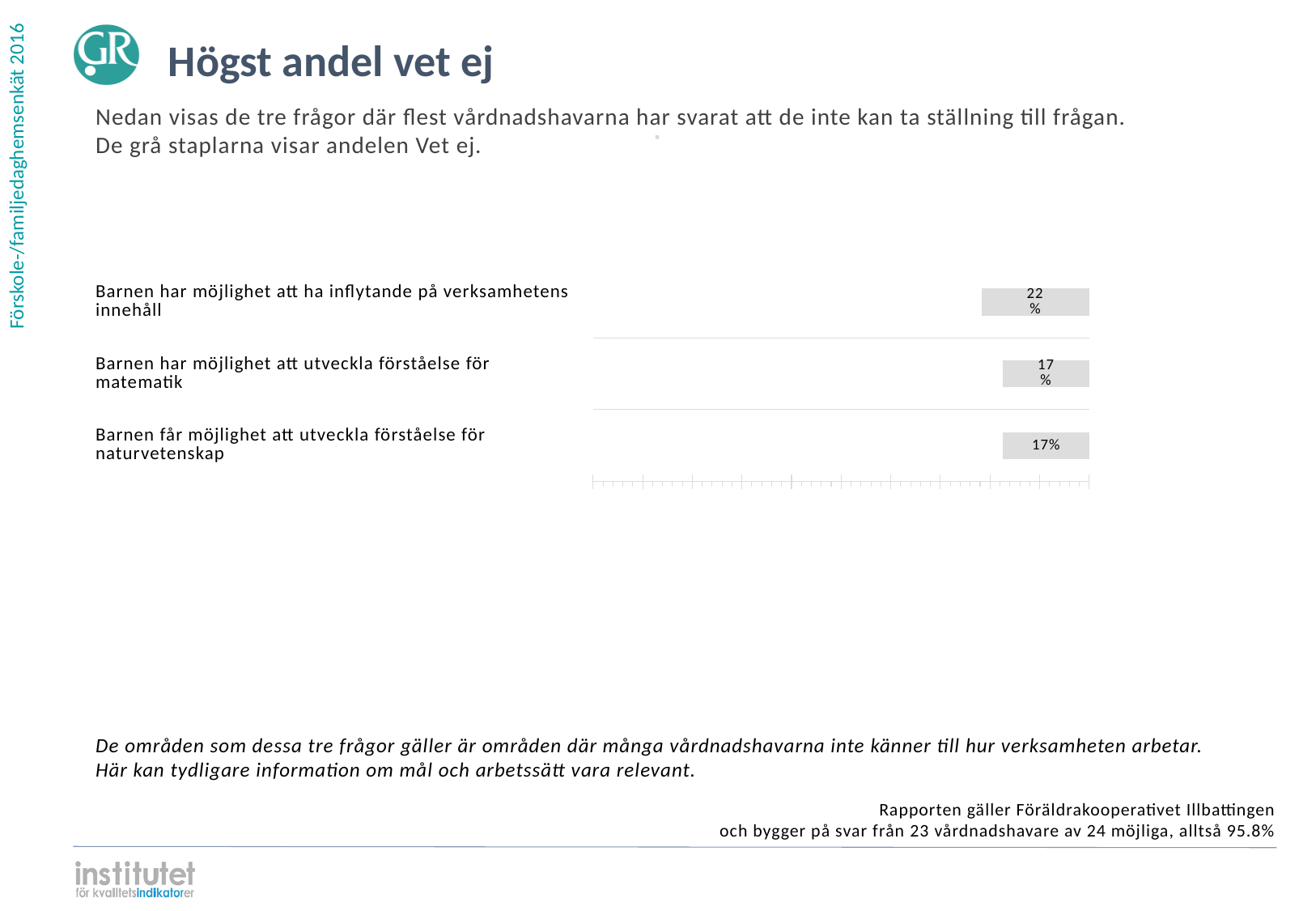
What is the value for "Barnen har möjlighet att utveckla förståelse för matematik"? 17% What kind of chart is shown on the slide? Bar chart What is the title of the slide containing the chart? Högst andel vet ej Do "Barnen har möjlighet att utveckla förståelse för matematik" and "Barnen får möjlighet att utveckla förståelse för naturvetenskap" have the same value? Yes What is the value for "Barnen får möjlighet att utveckla förståelse för naturvetenskap"? 17% What colour are the bars in the chart? Grey Which category has the highest value? Barnen har möjlighet att ha inflytande på verksamhetens innehåll What is the value for "Barnen har möjlighet att ha inflytande på verksamhetens innehåll"? 22% How many categories are shown in the chart? 3 Which is larger: the value for "Barnen har möjlighet att ha inflytande på verksamhetens innehåll" or the value for "Barnen får möjlighet att utveckla förståelse för naturvetenskap"? Barnen har möjlighet att ha inflytande på verksamhetens innehåll What is the difference between the value for "Barnen har möjlighet att ha inflytande på verksamhetens innehåll" and the value for "Barnen har möjlighet att utveckla förståelse för matematik"? 5 percentage points